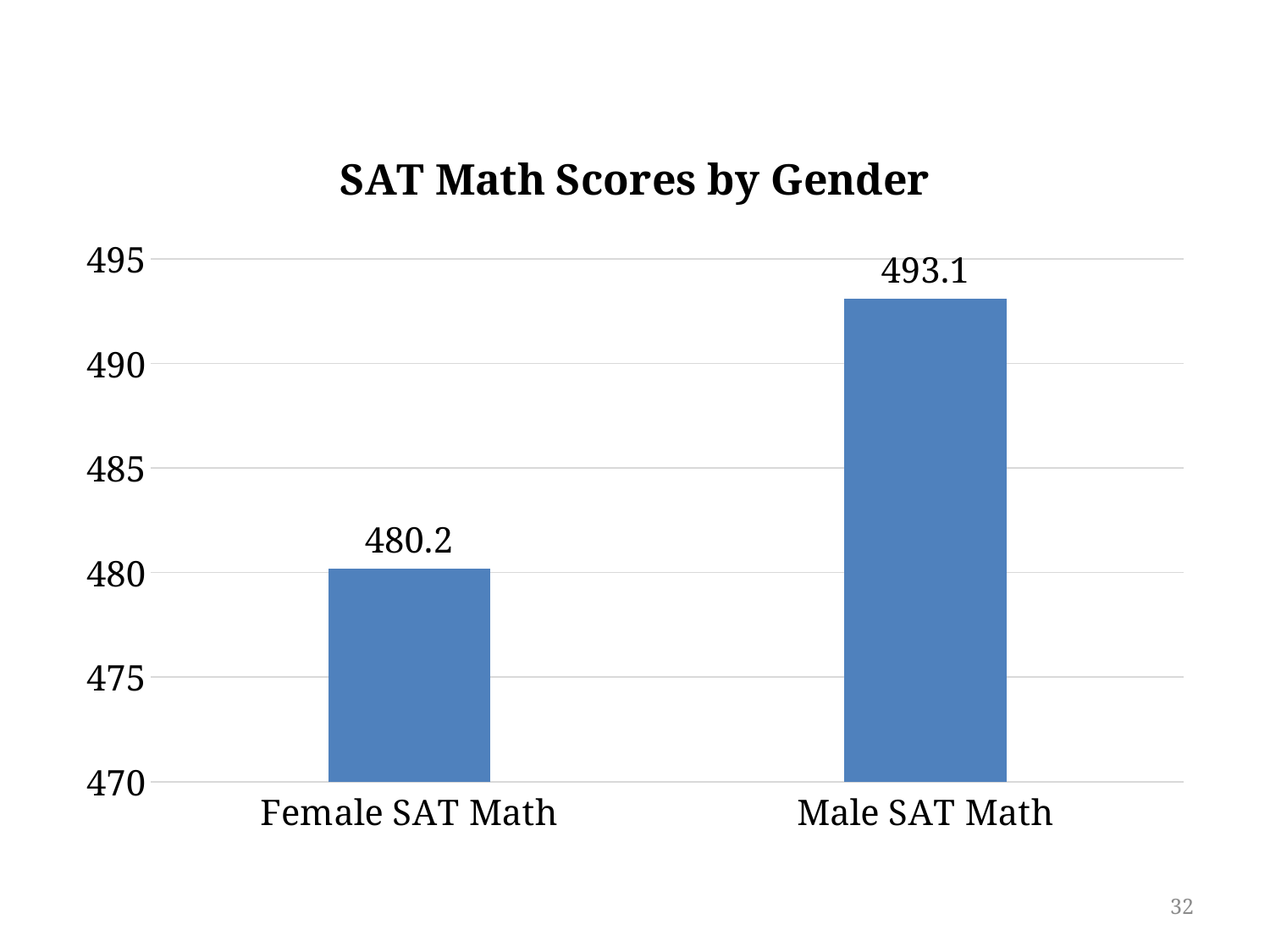
What is the value for Male SAT Math? 493.1 What is the value for Female SAT Math? 480.2 Is the value for Male SAT Math greater or less than 490? greater What is the lowest value shown on the vertical axis? 470 Which category has the lowest value? Female SAT Math What kind of chart is shown on the slide? bar chart How many categories are shown on the chart? 2 Which category has the highest value? Male SAT Math Which is larger, the value for Female SAT Math or Male SAT Math? Male SAT Math What is the title of the chart? SAT Math Scores by Gender Is the value for Female SAT Math greater or less than 485? less What is the difference between the Male SAT Math and Female SAT Math values? 12.9